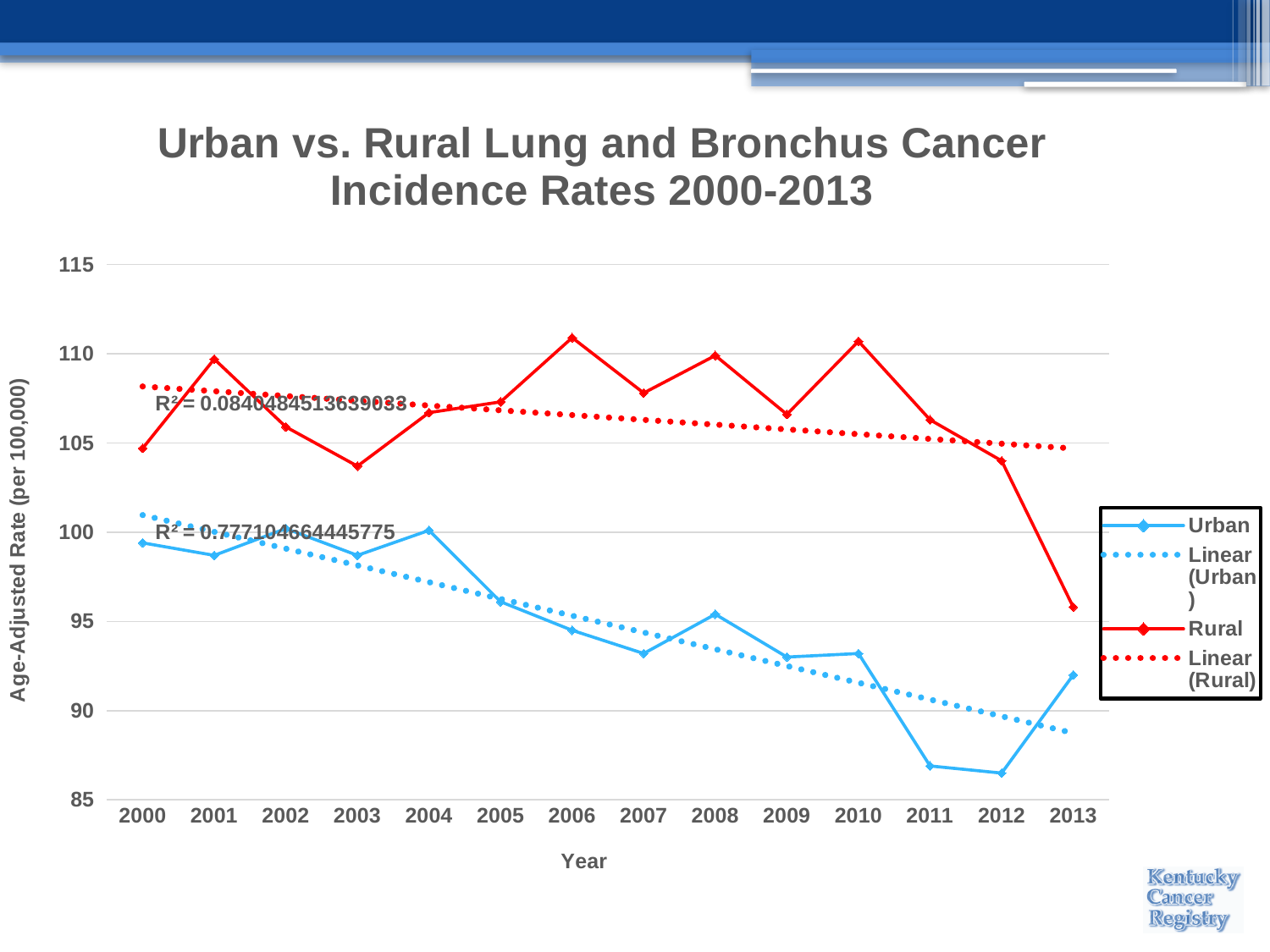
How many entries does the legend list? 4 Which year has the higher Urban value, 2007 or 2008? 2008 Which series has the higher value in 2013, Urban or Rural? Rural In which year is the Rural incidence rate lowest? 2013 Is the Urban value for 2011 greater or less than 90? less Does the Urban incidence rate generally rise or fall from 2000 to 2013? Fall How many years are plotted along the x axis? 14 What kind of chart is shown on the slide? Line chart Is the Rural value for 2006 greater or less than 110? greater What is the label of the y axis? Age-Adjusted Rate (per 100,000) Is the Urban value for 2004 greater or less than 95? greater